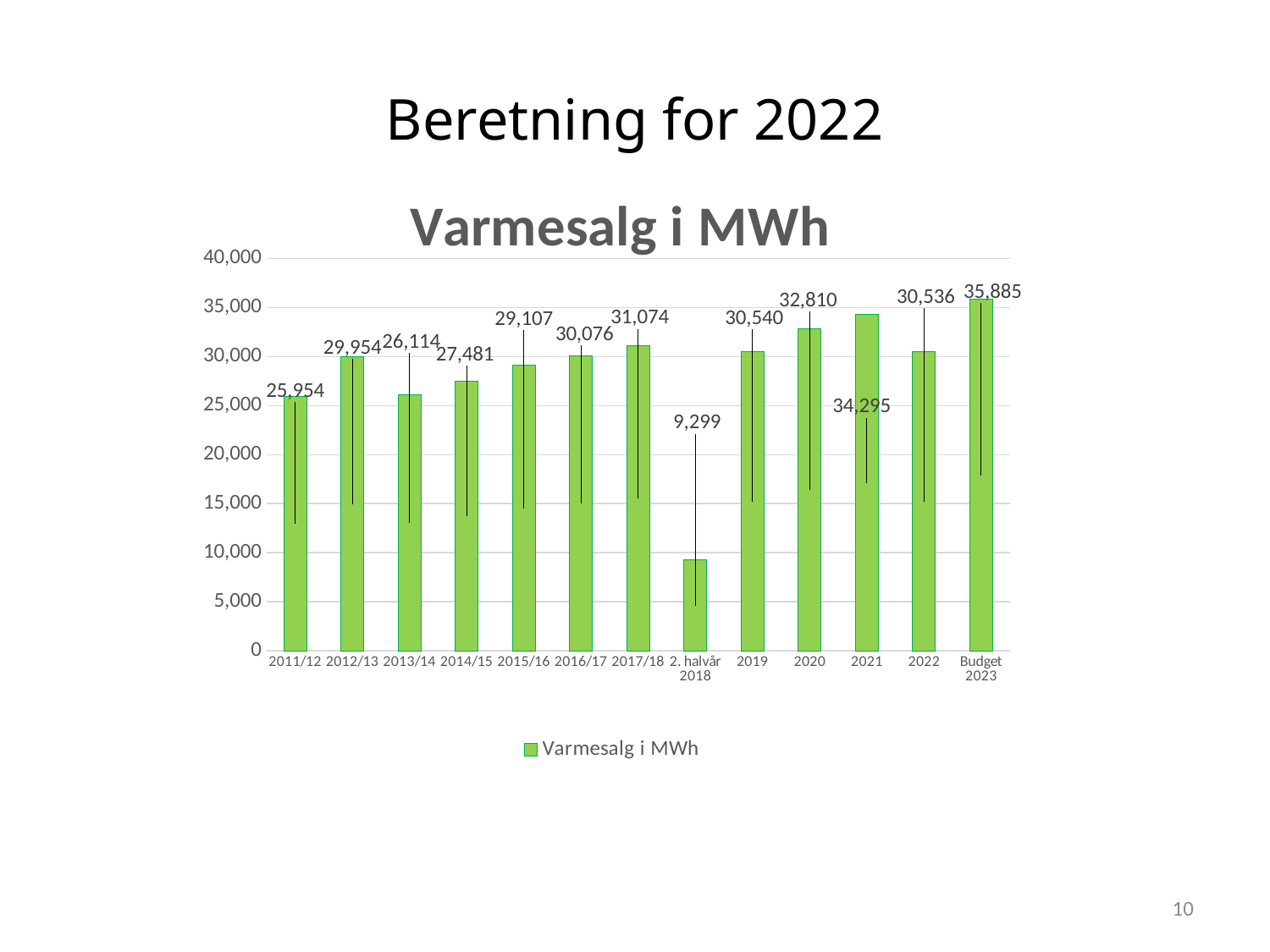
What kind of chart is shown on the slide? Bar chart Which category has the lowest value? 2. halvår 2018 What is the difference between the values for 2021 and 2022? 3,759 What is the value for 2022 in the Varmesalg i MWh chart? 30,536 Is the value for 2021 greater or less than 30,000? greater Which category has the highest value? Budget 2023 How many categories are shown on the x axis? 13 How many series does the legend list? 1 What is the value for 2. halvår 2018? 9,299 What is the value for Budget 2023? 35,885 What is the difference between Budget 2023 and 2022? 5,349 Which is larger, the value for 2020 or the value for 2021? 2021